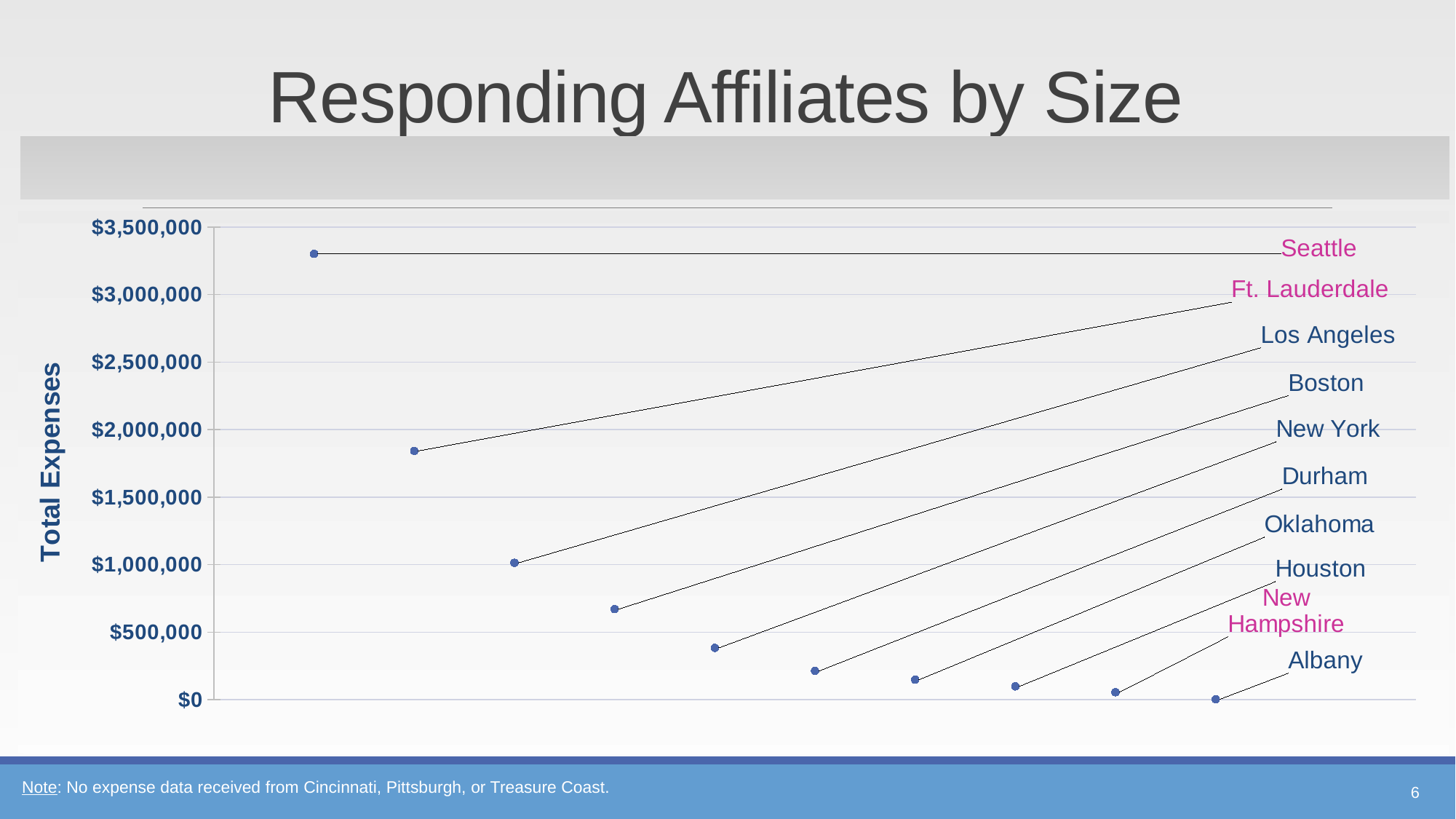
Do the plotted values rise or fall from left to right along the x axis? Fall How many affiliates are plotted on the chart? 10 Is the value for Boston greater or less than $500,000? greater What is the title of the vertical axis? Total Expenses What kind of chart is shown on the slide? Scatter chart Is the value for Seattle greater or less than $3,000,000? greater What is the title of the chart slide? Responding Affiliates by Size Is the value for New York greater or less than $500,000? less Which has higher total expenses, Los Angeles or Boston? Los Angeles Which affiliate has the lowest total expenses? Albany Which affiliate has the highest total expenses? Seattle